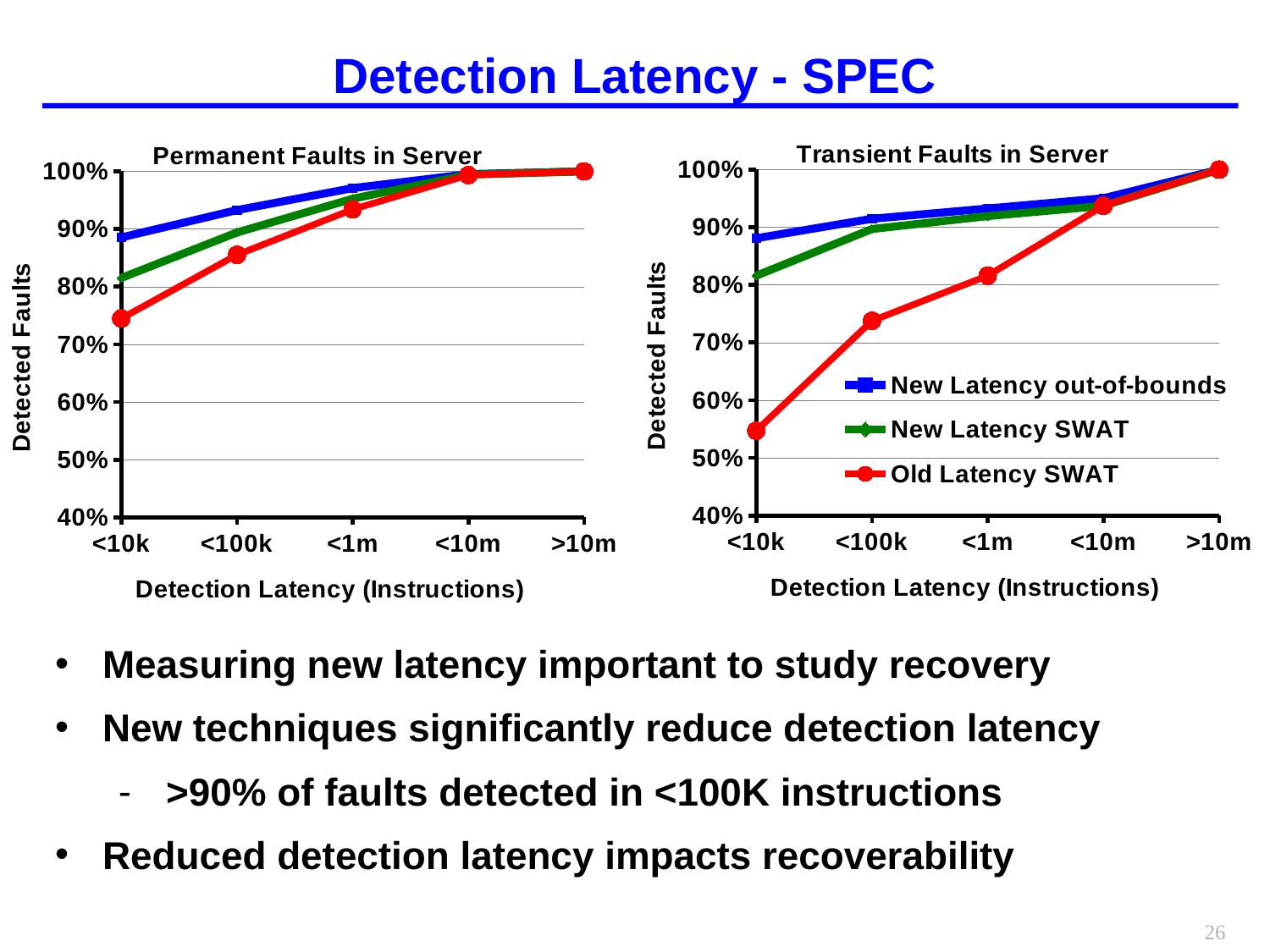
In the "Transient Faults in Server" chart, which is larger at <100k: New Latency out-of-bounds or Old Latency SWAT? New Latency out-of-bounds In the "Transient Faults in Server" chart, is the value for Old Latency SWAT at <100k greater or less than 80%? less In the "Permanent Faults in Server" chart, do the values for Old Latency SWAT rise or fall as detection latency increases along the x axis? rise What kind of chart is the "Permanent Faults in Server" chart? line chart In the "Transient Faults in Server" chart, is the value for Old Latency SWAT at <10k greater or less than 60%? less In the "Permanent Faults in Server" chart, is the value for Old Latency SWAT at <10k greater or less than 70%? greater How many series does the legend on the "Transient Faults in Server" chart list? 3 In the "Transient Faults in Server" chart, which series has the lowest value at <10k? Old Latency SWAT In the "Transient Faults in Server" chart, what value does Old Latency SWAT reach at >10m? 100% How many detection latency categories are shown on the x axis of the "Permanent Faults in Server" chart? 5 What is the y-axis label on the "Permanent Faults in Server" chart? Detected Faults